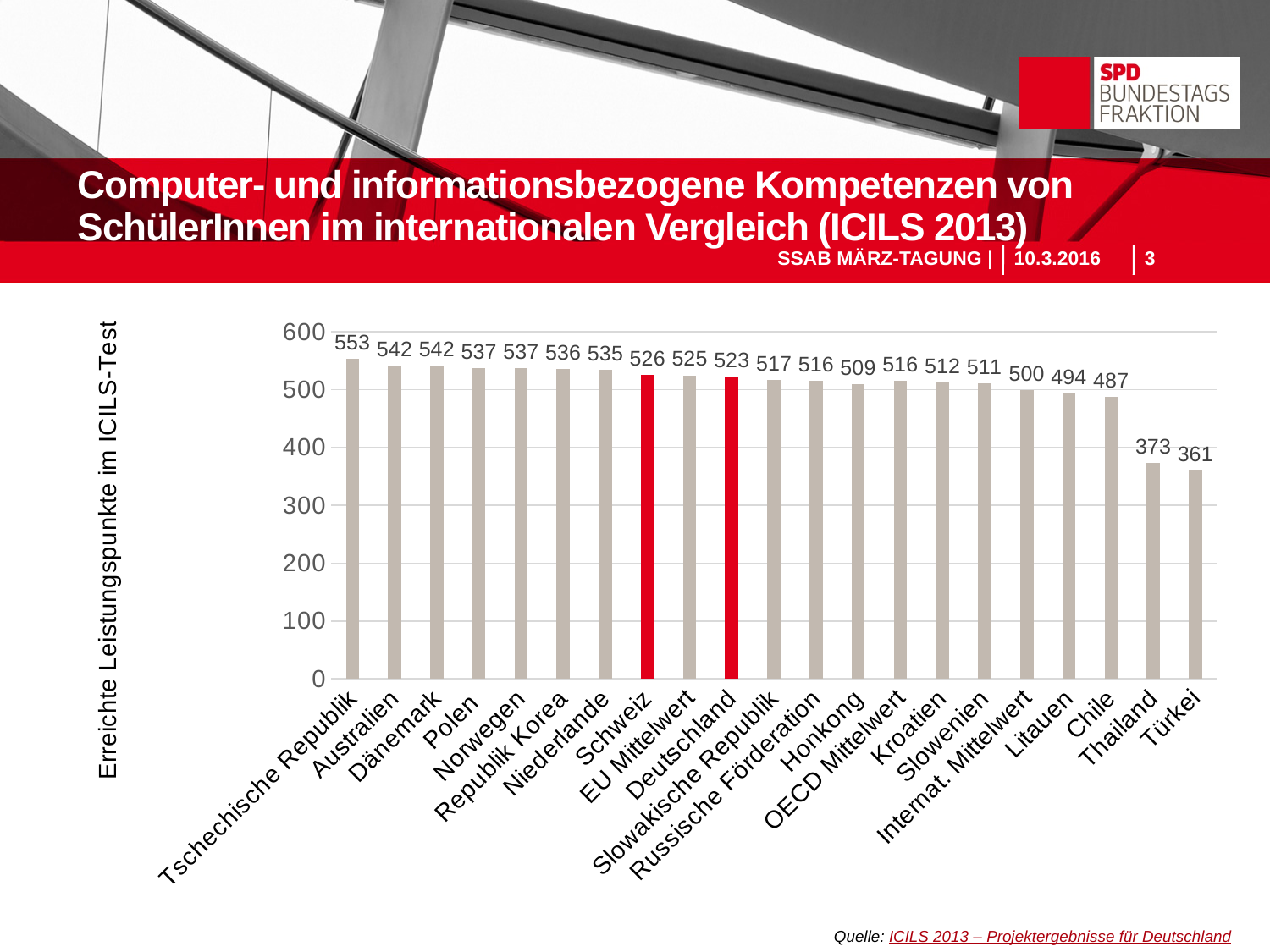
What is the difference between the values for Tschechische Republik and Türkei? 192 What value is shown for Deutschland? 523 What is the difference between the values for Deutschland and Internat. Mittelwert? 23 Which category has the lowest value? Türkei What value is shown for Tschechische Republik? 553 Which category has the highest value? Tschechische Republik Which two bars are highlighted in red? Schweiz and Deutschland Which is larger, the value for Schweiz or the value for Chile? Schweiz What value is shown for Thailand? 373 What value is shown for EU Mittelwert? 525 How many categories are shown on the x axis? 21 What kind of chart is shown on the slide? Bar chart